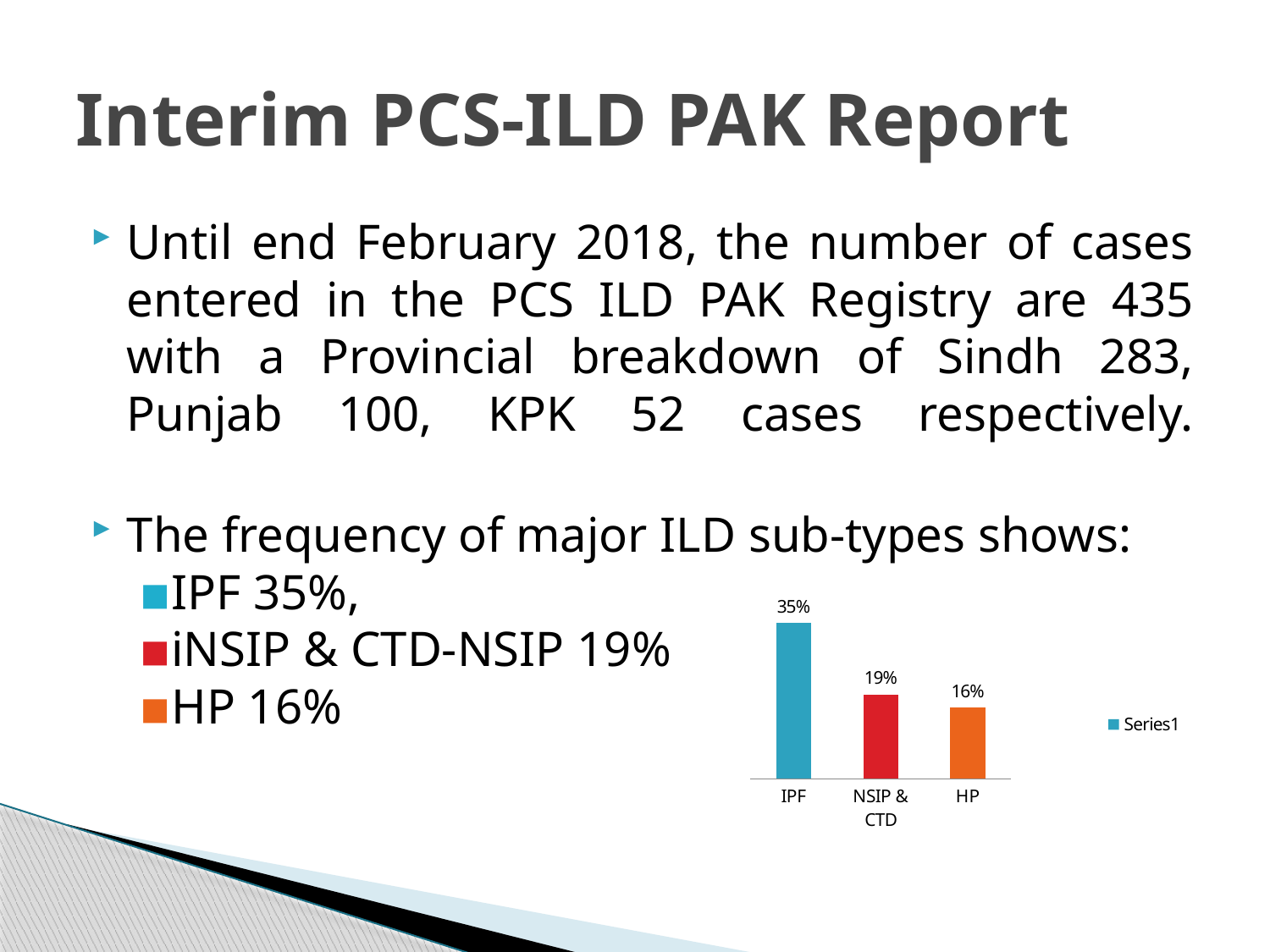
Which is larger in the bar chart, the value for IPF or the value for NSIP & CTD? IPF Which category has the lowest value in the bar chart? HP What is the value for IPF in the bar chart? 35% What is the name of the series shown in the chart legend? Series1 How many series does the chart legend list? 1 What is the difference between the values for IPF and HP in the bar chart? 19% Which category has the highest value in the bar chart? IPF What is the difference between the values for NSIP & CTD and HP in the bar chart? 3% What kind of chart is shown on the slide? Bar chart What is the value for HP in the bar chart? 16% How many categories are shown in the bar chart? 3 What is the value for NSIP & CTD in the bar chart? 19%